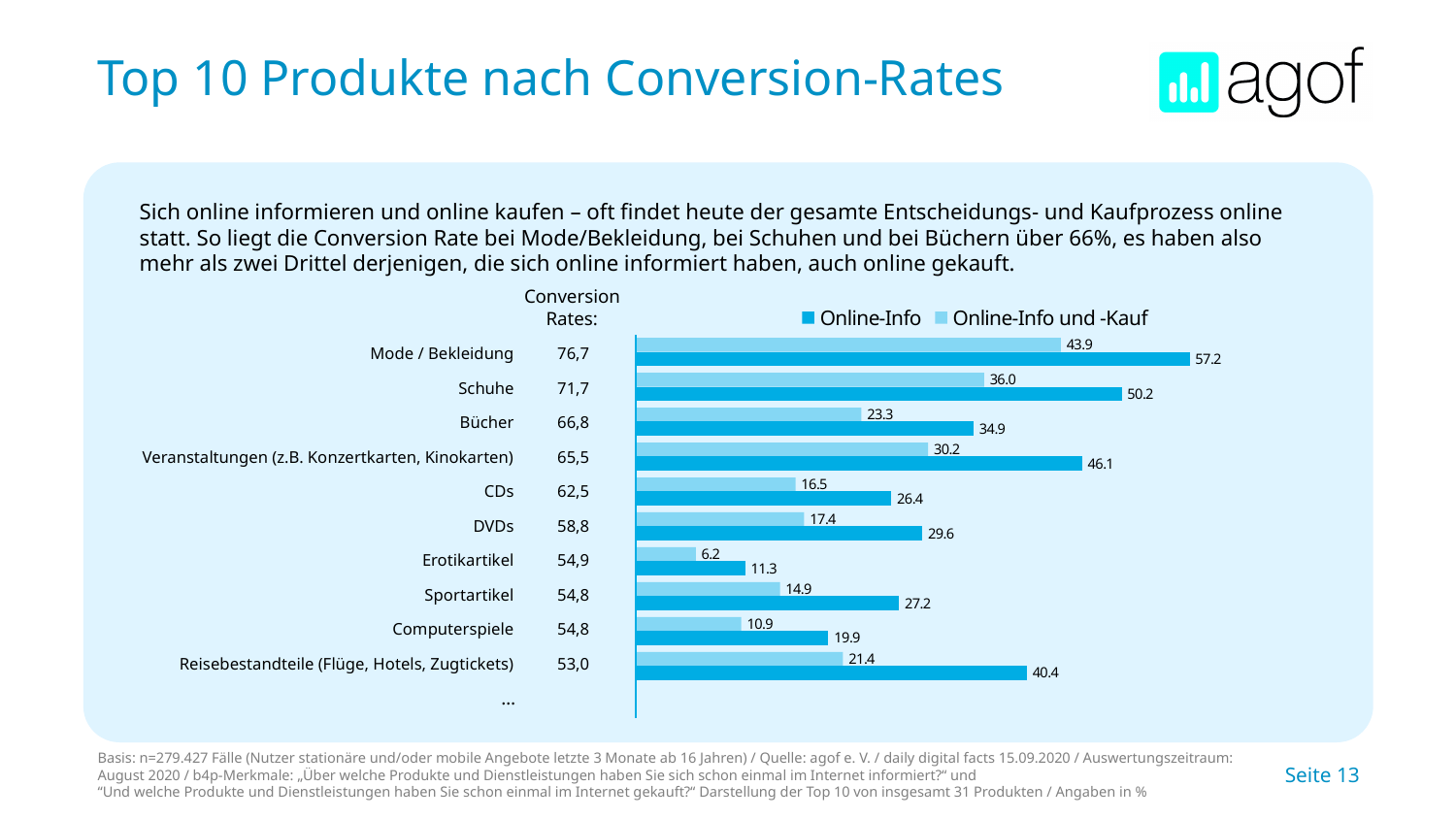
How many product categories are plotted in the chart? 10 What type of chart is shown on the slide? Bar chart Which category has the lowest Online-Info und -Kauf value? Erotikartikel How many series does the legend list? 2 What is the Online-Info value for Reisebestandteile (Flüge, Hotels, Zugtickets)? 40.4 What is the difference between the Online-Info and Online-Info und -Kauf values for Bücher? 11.6 What is the Online-Info value for Schuhe? 50.2 What is the Online-Info und -Kauf value for Computerspiele? 10.9 What is the Online-Info und -Kauf value for Veranstaltungen (z.B. Konzertkarten, Kinokarten)? 30.2 Which is larger: the Online-Info value for DVDs or the Online-Info value for CDs? DVDs Which category has the highest Online-Info value? Mode / Bekleidung What is the conversion rate listed for Mode / Bekleidung? 76,7